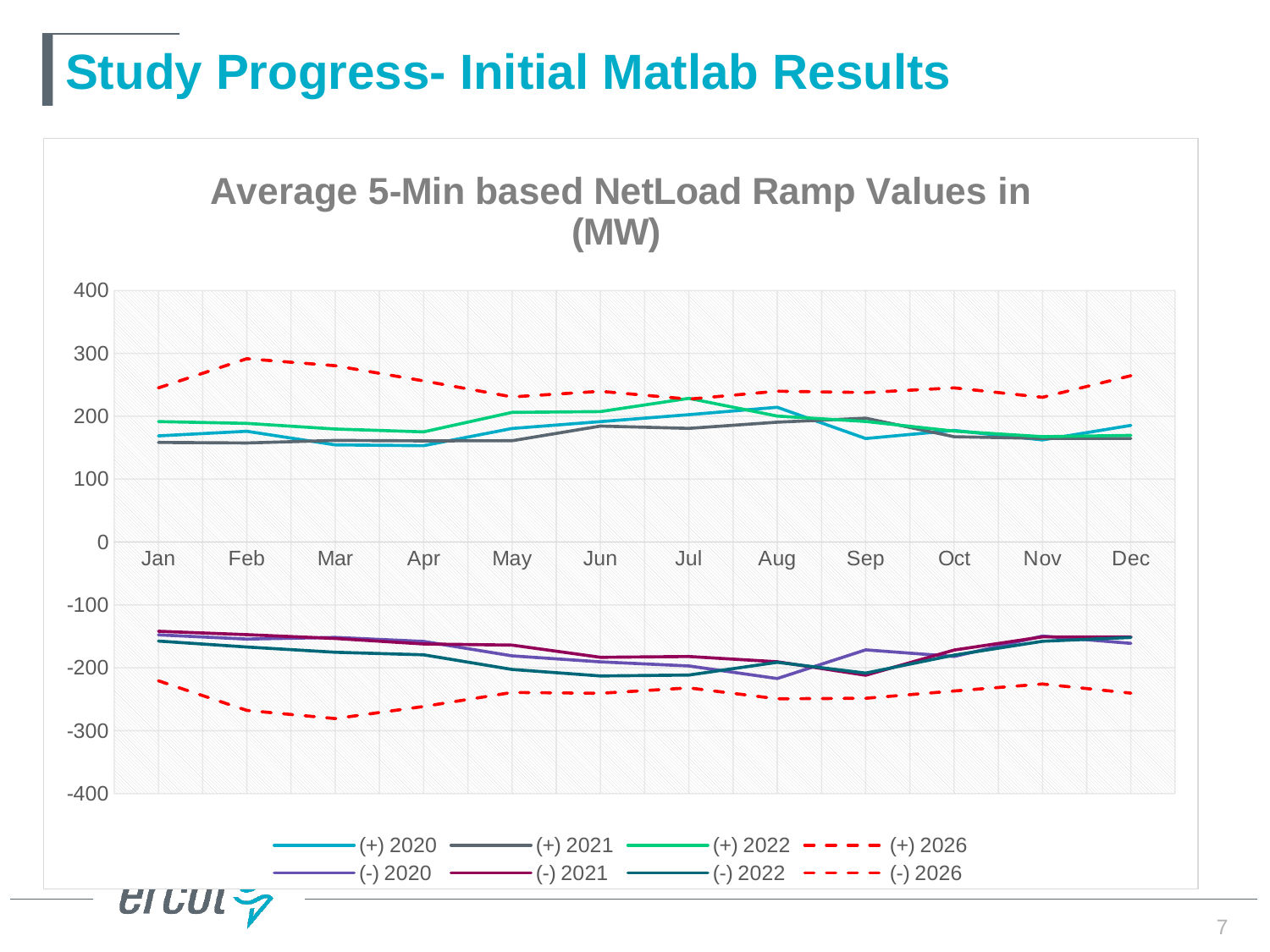
What kind of chart is shown on the slide? Line chart Is the value for (-) 2026 in Mar greater or less than -200? less How many months are plotted along the x axis? 12 Is the value for (+) 2026 in Feb greater or less than 250? greater Which series has the lowest values across all months? (-) 2026 How many series does the legend list? 8 Which series are drawn with dashed lines? (+) 2026 and (-) 2026 In Jan, which is larger: the value for (+) 2026 or the value for (+) 2020? (+) 2026 Is the value for (+) 2021 in Jan greater or less than 200? less What is the title of the chart? Average 5-Min based NetLoad Ramp Values in (MW) Does the (+) 2020 line rise or fall from Aug to Sep? Fall